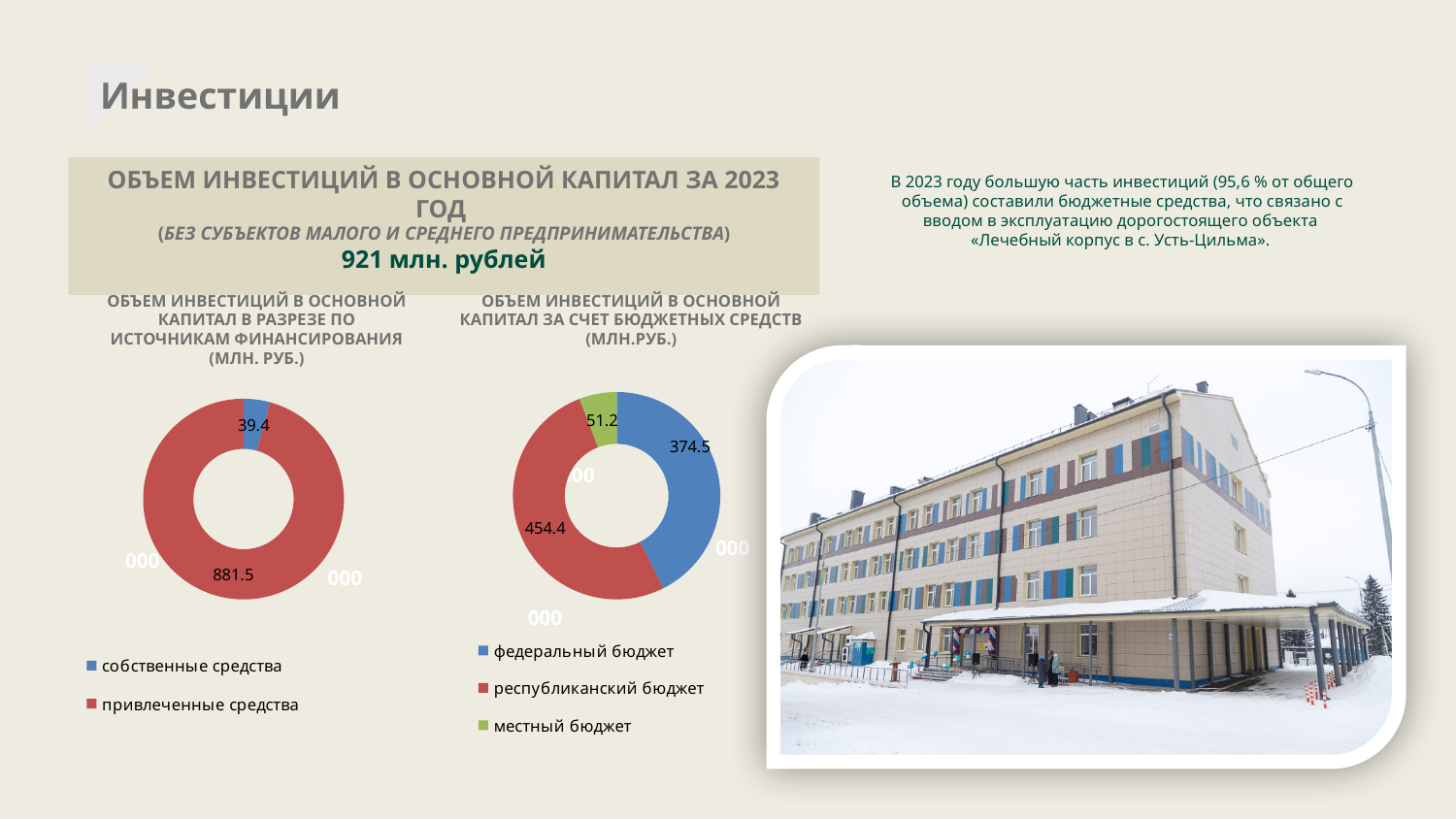
In the right chart (investments from budget funds), which is larger: республиканский бюджет or федеральный бюджет? республиканский бюджет In the left chart (investments by source of financing), what is the value for привлеченные средства? 881.5 In the right chart (investments from budget funds), what is the value for республиканский бюджет? 454.4 In the right chart (investments from budget funds), how many categories are shown? 3 In the left chart (investments by source of financing), what is the difference between привлеченные средства and собственные средства? 842.1 In the right chart (investments from budget funds), which category has the smallest value? местный бюджет In the left chart (investments by source of financing), what is the value for собственные средства? 39.4 What type of chart is the right chart (investments from budget funds)? doughnut chart In the right chart (investments from budget funds), what is the value for местный бюджет? 51.2 In the left chart (investments by source of financing), how many series does the legend list? 2 In the right chart (investments from budget funds), what is the value for федеральный бюджет? 374.5 In the left chart (investments by source of financing), which category has the largest value? привлеченные средства